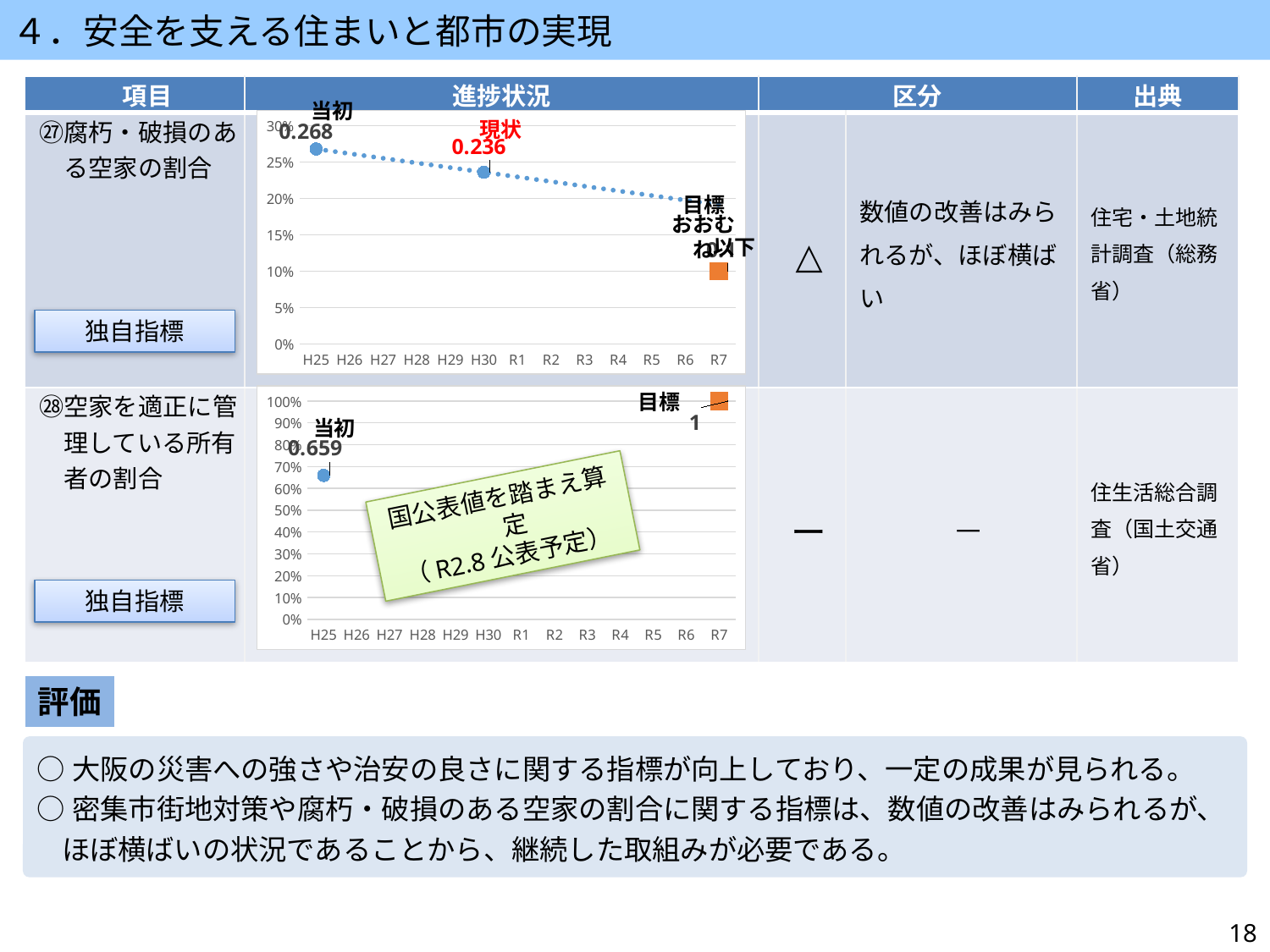
What is the highest value shown on the y axis of the top chart (㉗腐朽・破損のある空家の割合)? 30% In the top chart (㉗腐朽・破損のある空家の割合), what is the value labelled 当初? 0.268 In the top chart (㉗腐朽・破損のある空家の割合), do the plotted values rise or fall from H25 to H30? fall In the bottom chart (㉘空家を適正に管理している所有者の割合), what is the value labelled 目標? 1 In the top chart (㉗腐朽・破損のある空家の割合), what is the value labelled 現状? 0.236 How many categories are shown on the x axis of the top chart (㉗腐朽・破損のある空家の割合)? 13 In the top chart (㉗腐朽・破損のある空家の割合), is the 目標 marker at R7 greater or less than 15%? less In the bottom chart (㉘空家を適正に管理している所有者の割合), what is the value labelled 当初? 0.659 In the bottom chart (㉘空家を適正に管理している所有者の割合), is the H25 value greater or less than 60%? greater In the top chart (㉗腐朽・破損のある空家の割合), what is the difference between the 当初 value and the 現状 value? 0.032 In the top chart (㉗腐朽・破損のある空家の割合), which is larger, the 当初 value or the 現状 value? 当初 What kind of chart is the top chart (㉗腐朽・破損のある空家の割合)? line chart